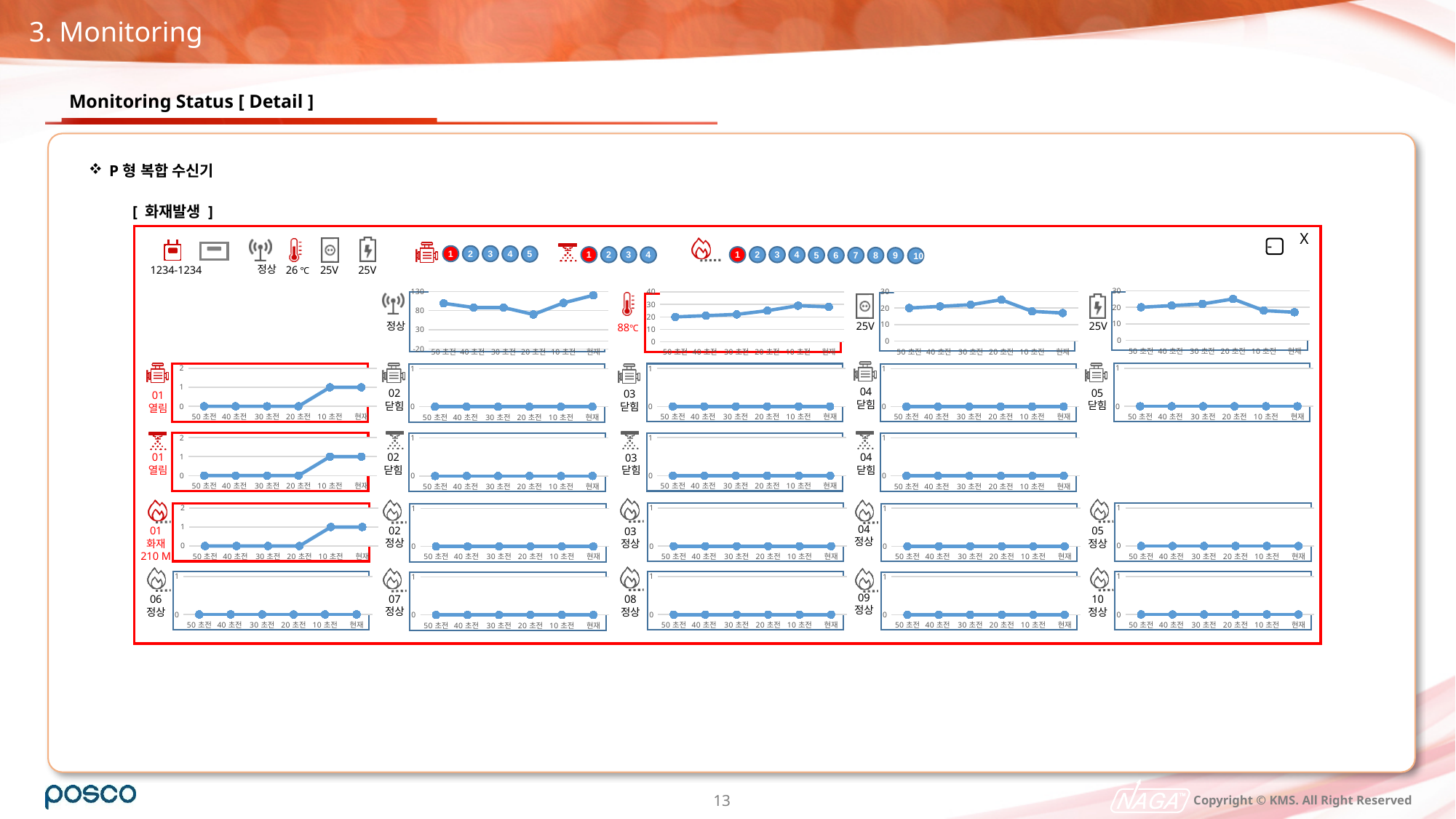
What is the label of the last x-axis category in the 01 열림 chart at the top-left of the grid? 현재 In the 01 열림 chart at the top-left of the grid, what is the difference between the value at 현재 and the value at 20 초전? 1 In the 01 화재 chart (third row, left), what is the value at 10 초전? 1 In the temperature chart labeled 88℃ in the top row, is the value at 50 초전 greater or less than 30? less How many data points are plotted in the 01 열림 chart at the top-left of the grid? 6 What kind of chart is used for the 01 열림 panel at the top-left of the grid? line chart In the 01 열림 chart at the top-left of the grid, do the values rise or fall from 50 초전 to 현재? rise In the signal chart labeled 정상 in the top row, is the value at 현재 greater or less than 80? greater In the 01 열림 chart at the top-left of the grid, what is the value at 현재? 1 In the temperature chart labeled 88℃ in the top row, is the value at 현재 greater or less than 20? greater In the 02 닫힘 chart in the second row, what is the value at 현재? 0 In the 01 열림 chart at the top-left of the grid, what is the value at 50 초전? 0